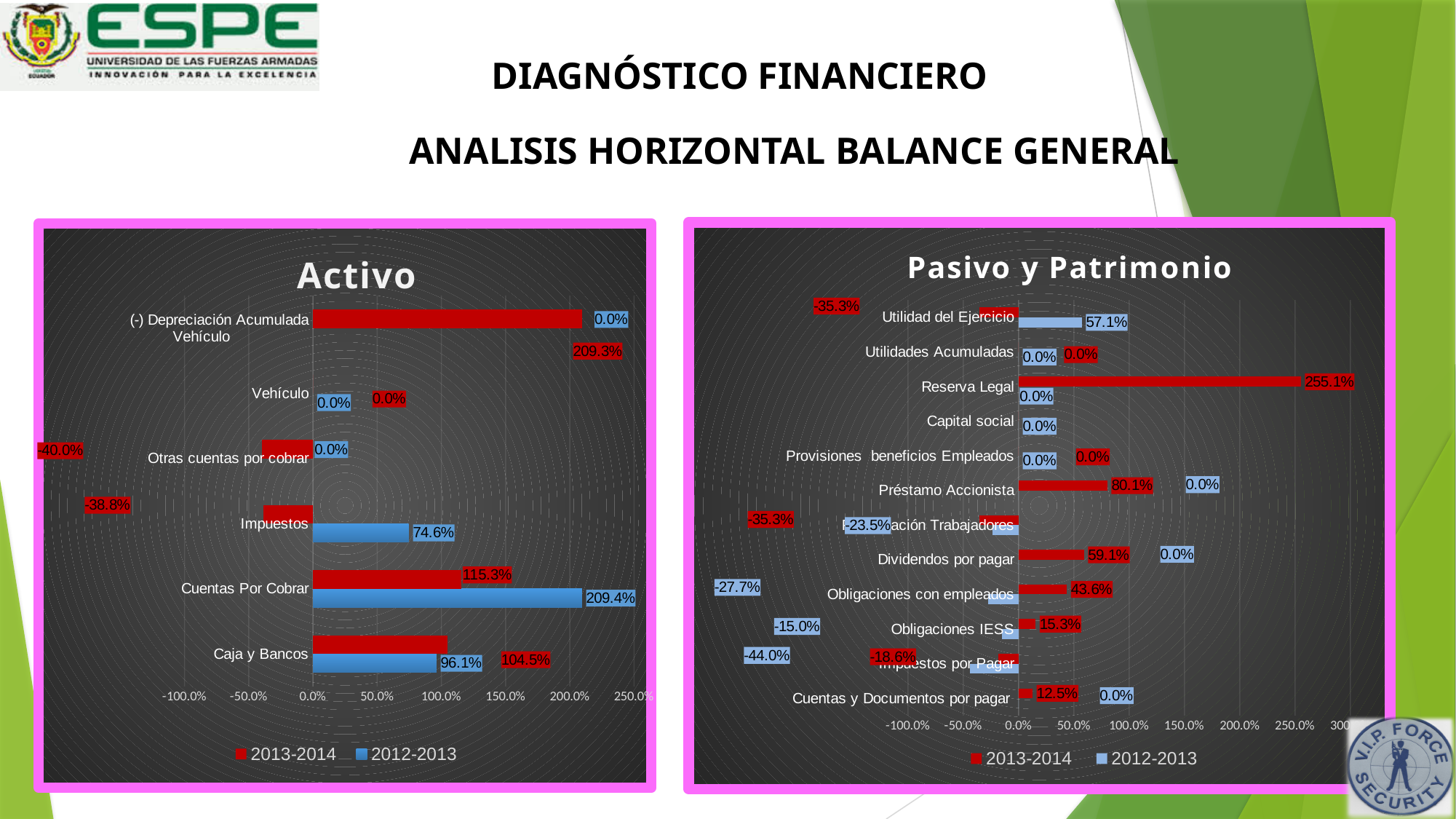
In the Activo chart, what is the 2012-2013 value for Cuentas Por Cobrar? 209.4% In the Pasivo y Patrimonio chart, what is the 2012-2013 value for Utilidad del Ejercicio? 57.1% In the Activo chart, how many categories are shown? 6 In the Activo chart, which category has the highest 2013-2014 value? (-) Depreciación Acumulada Vehículo In the Activo chart, what is the difference between the 2012-2013 and 2013-2014 values for Cuentas Por Cobrar? 94.1% In the Pasivo y Patrimonio chart, which is larger for Obligaciones con empleados: the 2013-2014 value or the 2012-2013 value? 2013-2014 In the Pasivo y Patrimonio chart, what is the 2012-2013 value for Impuestos por Pagar? -44.0% In the Activo chart, what is the 2013-2014 value for Caja y Bancos? 104.5% What type of chart is the Activo chart? Bar chart In the Activo chart, what is the 2013-2014 value for Impuestos? -38.8% How many series does the legend of the Pasivo y Patrimonio chart list? 2 In the Pasivo y Patrimonio chart, what is the 2013-2014 value for Reserva Legal? 255.1%